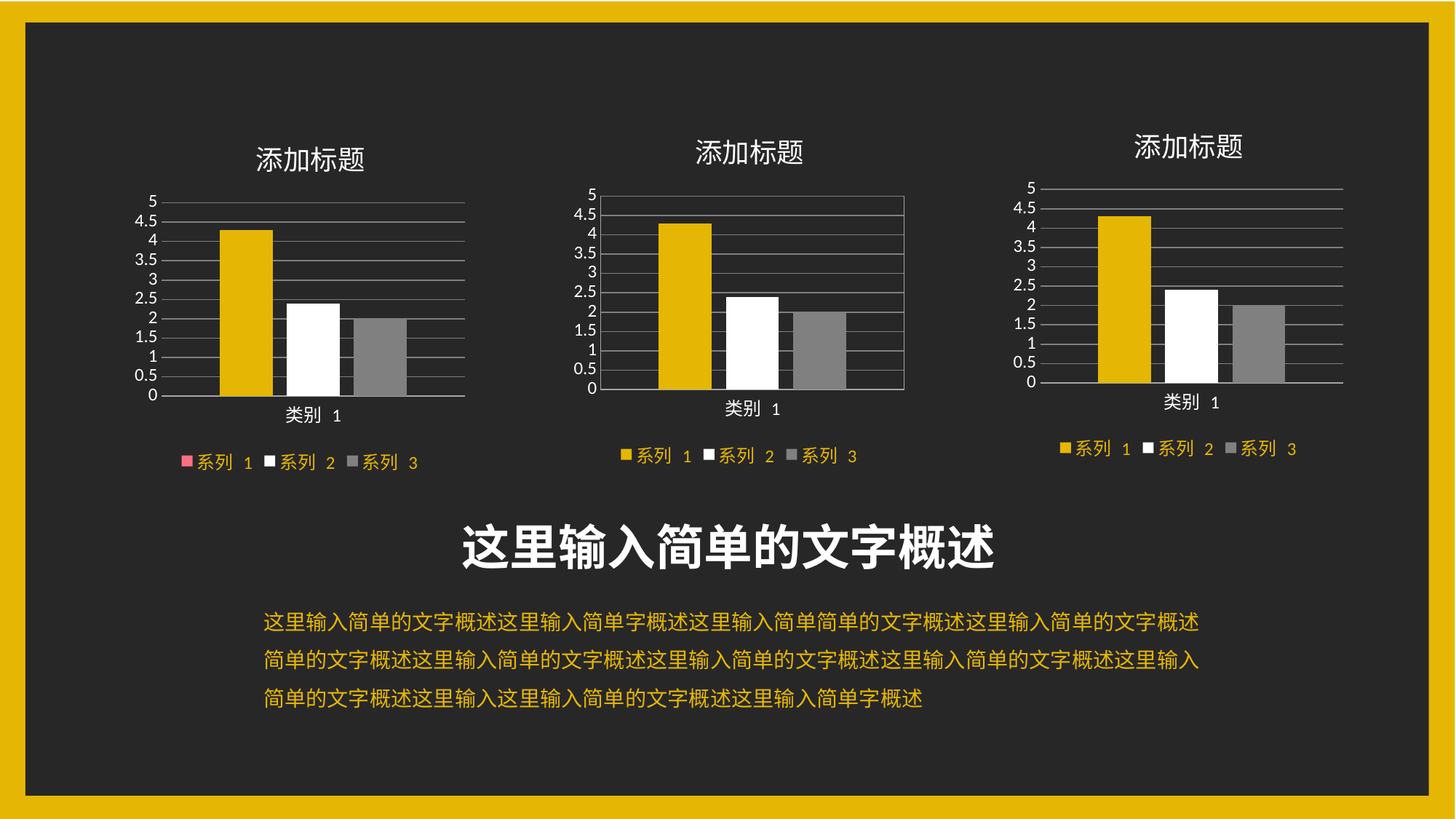
In the left chart, which series has the highest bar? 系列 1 In the right chart, which is larger, the bar for 系列 1 or the bar for 系列 2? 系列 1 In the middle chart, is the value for 系列 3 greater or less than 1? greater What is the title of the middle chart? 添加标题 In the left chart, is the value for 系列 2 greater or less than 3? less In the middle chart, is the value for 系列 1 greater or less than 3? greater How many categories are shown on the x axis of the right chart? 1 What type of chart is the left chart? bar chart How many series does the legend of the middle chart list? 3 What is the category label on the x axis of the left chart? 类别 1 In the middle chart, which series has the lowest bar? 系列 3